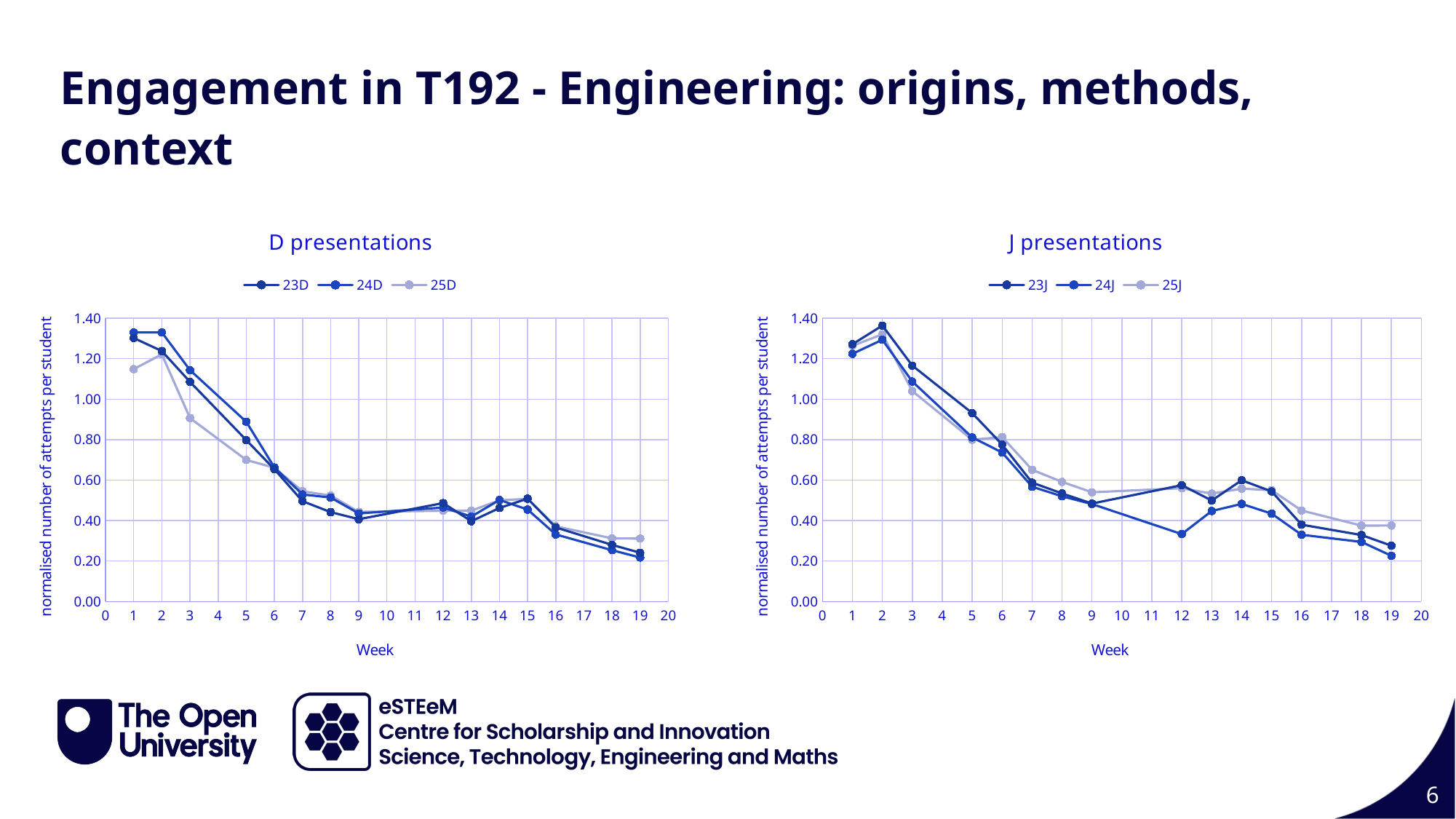
In the D presentations chart, is the value for 25D at week 3 greater or less than 1.00? less In the D presentations chart, at week 1, which series has the lower value, 23D or 25D? 25D In the J presentations chart, do the values generally rise or fall from week 2 to week 19? fall How many series does the legend of the J presentations chart list? 3 What is the label of the vertical axis on the J presentations chart? normalised number of attempts per student In the J presentations chart, is the value for 23J at week 2 greater or less than 1.20? greater In the J presentations chart, is the value for 24J at week 12 greater or less than 0.40? less In the J presentations chart, at week 12, which series has the higher value, 23J or 24J? 23J In the D presentations chart, do the values generally rise or fall as the week number increases? fall What kind of chart is the D presentations chart? line chart